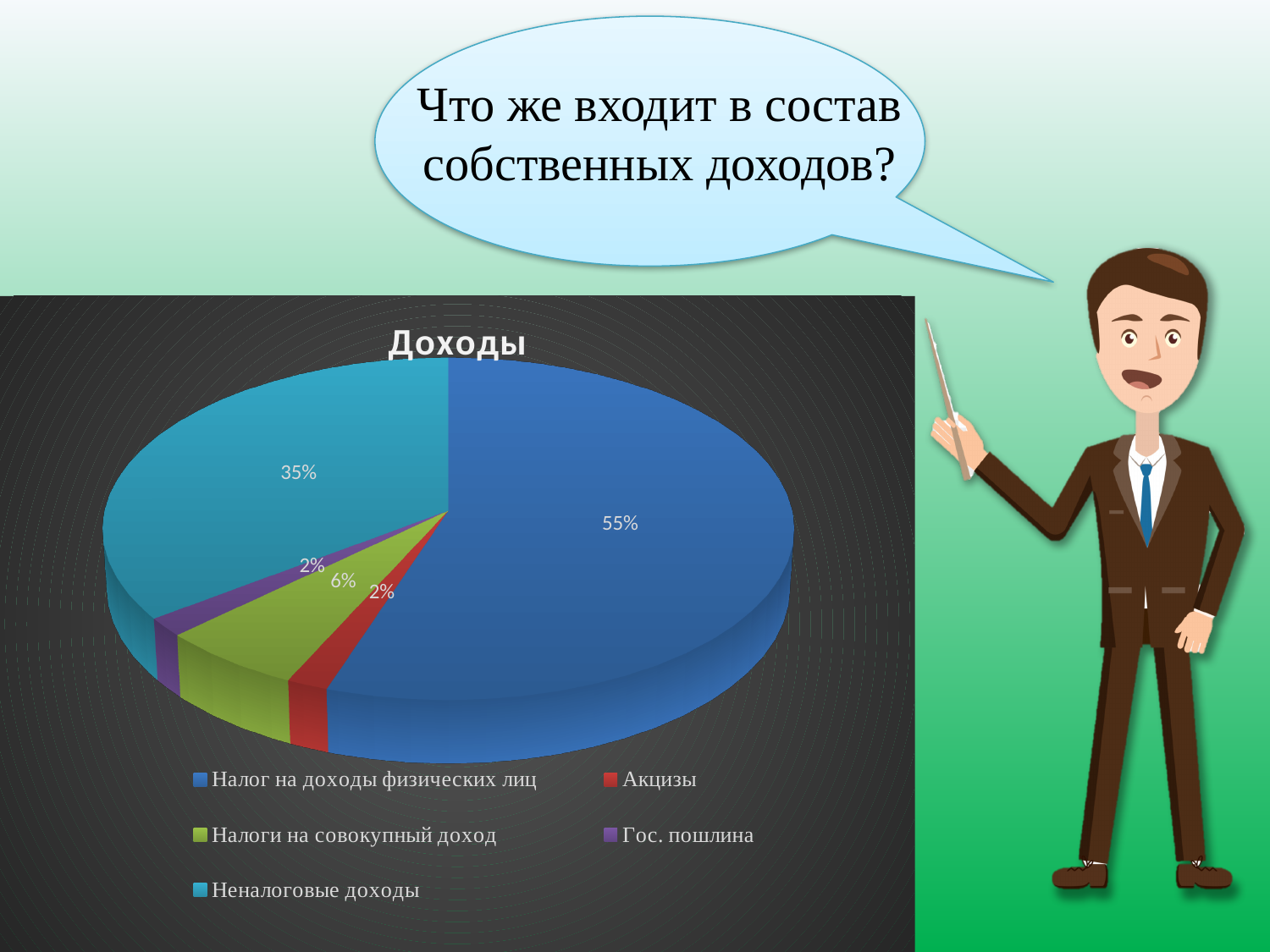
What share of the pie does "Гос. пошлина" have? 2% What share of the pie does "Акцизы" have? 2% What share of the pie does "Налог на доходы физических лиц" have? 55% What share of the pie does "Налоги на совокупный доход" have? 6% What share of the pie does "Неналоговые доходы" have? 35% How many categories does the pie chart show? 5 What type of chart is shown on the slide? Pie chart Which is larger, the slice for "Налоги на совокупный доход" or the slice for "Акцизы"? Налоги на совокупный доход Which category has the largest slice of the pie? Налог на доходы физических лиц What is the difference in percentage points between "Налог на доходы физических лиц" and "Неналоговые доходы"? 20 percentage points What is the title of the chart? Доходы Which colour represents "Неналоговые доходы" in the legend? Teal